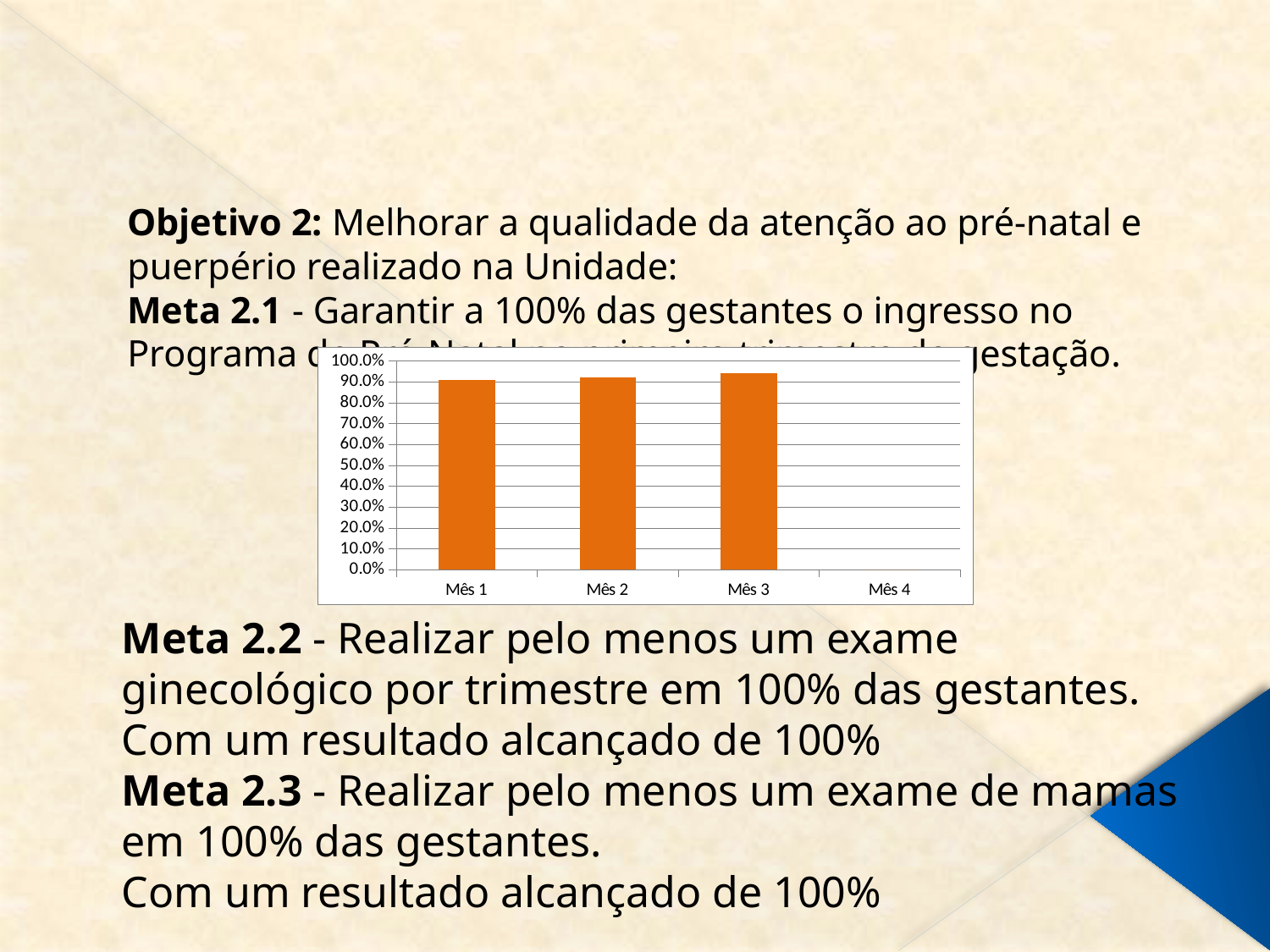
How many categories are shown on the x axis of the chart? 4 Do the bar values rise or fall from Mês 1 to Mês 3? rise Which category on the x axis has no visible bar? Mês 4 Which category on the x axis has the tallest bar? Mês 3 Is the value for Mês 2 greater or less than 70%? greater Is the value for Mês 1 greater or less than 80%? greater What colour are the bars in the chart? orange What is the highest value labelled on the y axis of the chart? 100.0% Is the value for Mês 3 greater or less than 100%? less What kind of chart is shown on the slide? bar chart Which is larger, the value for Mês 1 or the value for Mês 3? Mês 3